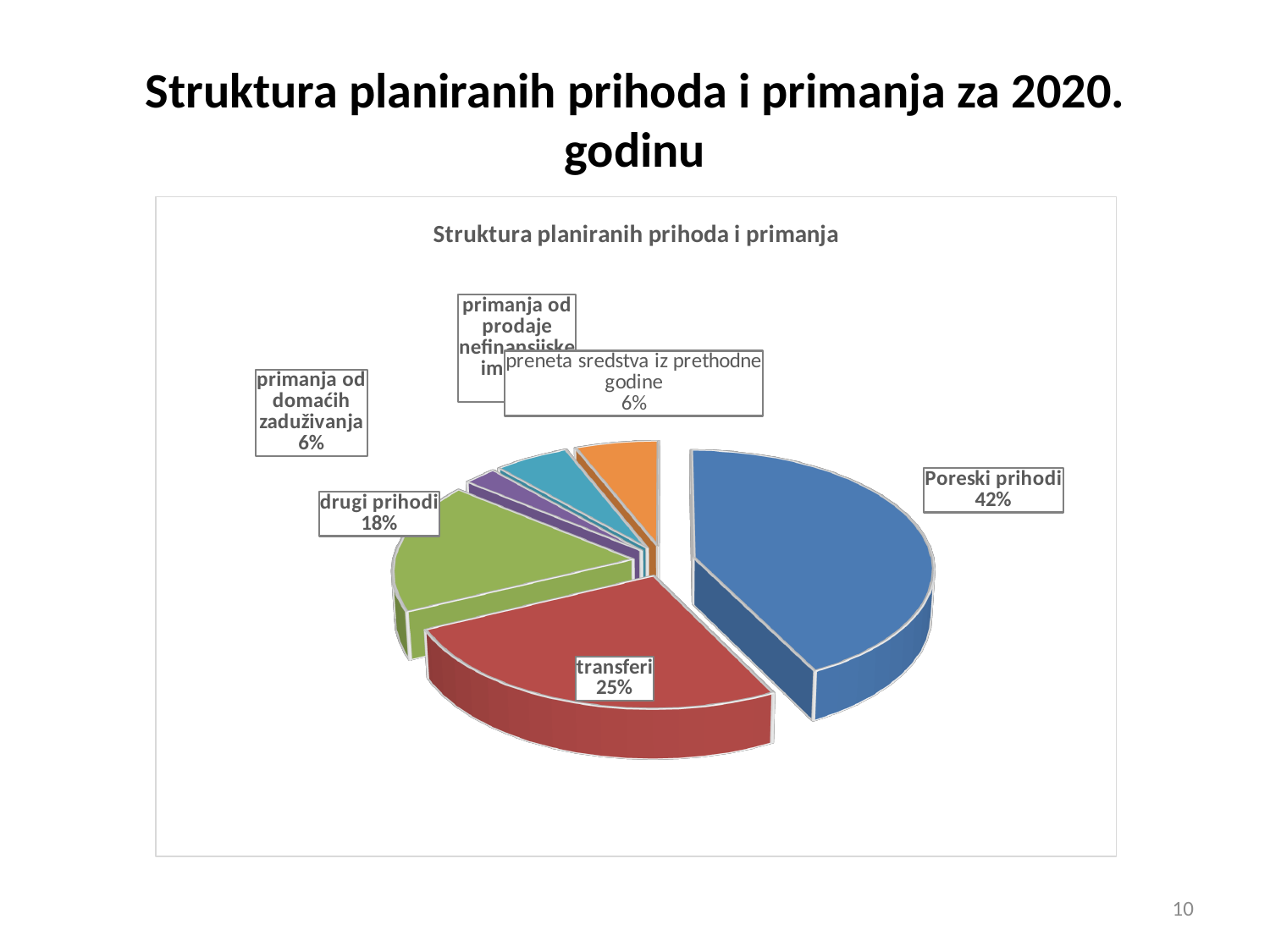
Which category has the largest share of the pie? Poreski prihodi How many slices does the pie chart have? 6 What percentage is shown for preneta sredstva iz prethodne godine? 6% What percentage is shown for primanja od domaćih zaduživanja? 6% What is the difference in percentage points between Poreski prihodi and transferi? 17 percentage points What percentage is shown for drugi prihodi? 18% What is the title of the chart? Struktura planiranih prihoda i primanja What type of chart is shown on the slide? Pie chart What percentage is shown for transferi? 25% What is the difference in percentage points between transferi and drugi prihodi? 7 percentage points Which is larger, the share for transferi or the share for drugi prihodi? transferi What share of the pie does Poreski prihodi represent? 42%